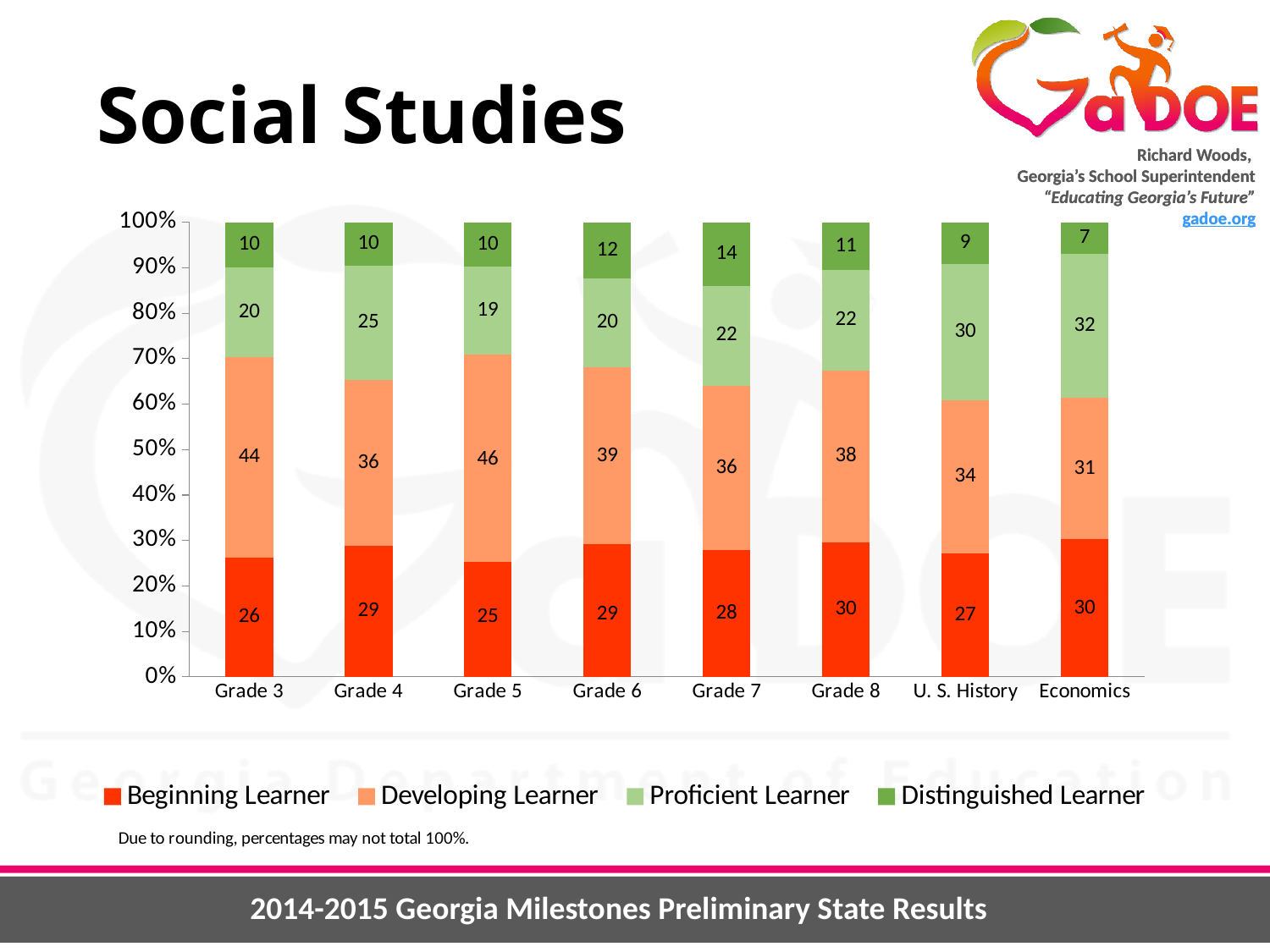
What percentage of Grade 3 students are Developing Learners? 44 What is the total of the four labelled values in the Grade 8 bar? 101 What kind of chart is shown on the slide? Stacked bar chart Which category has the lowest Beginning Learner value? Grade 5 Which category has the highest Developing Learner value? Grade 5 How many series does the legend list? 4 What is the Distinguished Learner value for Economics? 7 Which category has the highest Distinguished Learner value? Grade 7 How many categories are shown on the x axis? 8 What is the Proficient Learner value for U. S. History? 30 What is the difference between the Proficient Learner values for Economics and Grade 5? 13 Which is larger, the Beginning Learner value for Grade 4 or for Grade 7? Grade 4